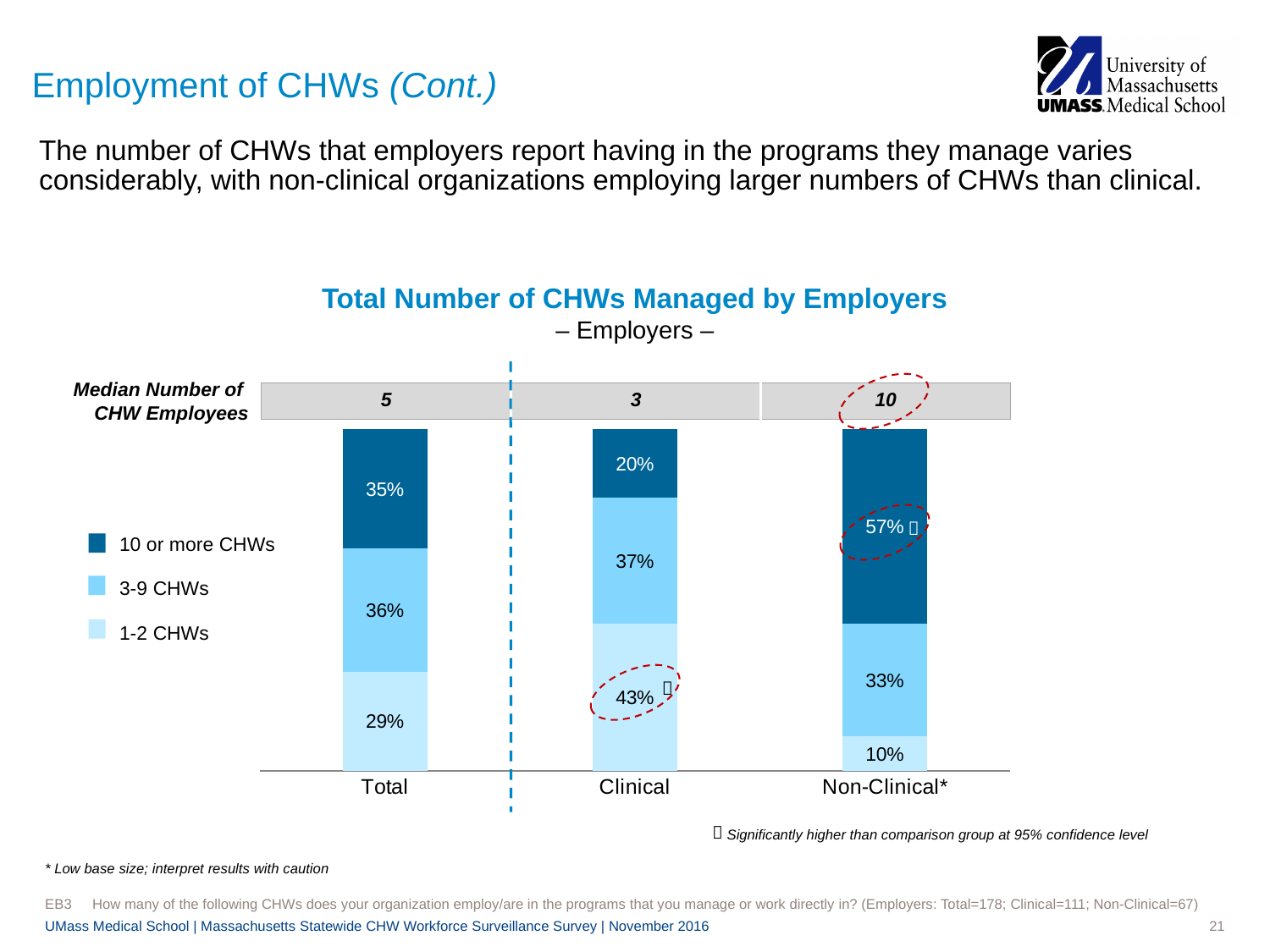
What percentage of Clinical employers manage 1-2 CHWs? 43% What percentage of Non-Clinical employers manage 10 or more CHWs? 57% What percentage of Total employers manage 3-9 CHWs? 36% What kind of chart is shown? Stacked bar chart Which category has the highest share of employers managing 10 or more CHWs? Non-Clinical* Which category has the lowest share of employers managing 1-2 CHWs? Non-Clinical* What is the title of the chart? Total Number of CHWs Managed by Employers Which is larger: the 1-2 CHWs share for Clinical or for Total employers? Clinical What is the median number of CHW employees for Non-Clinical employers? 10 How many series does the legend list? 3 How many categories are shown on the x axis? 3 What is the difference between the 10 or more CHWs share for Non-Clinical and Clinical employers? 37 percentage points